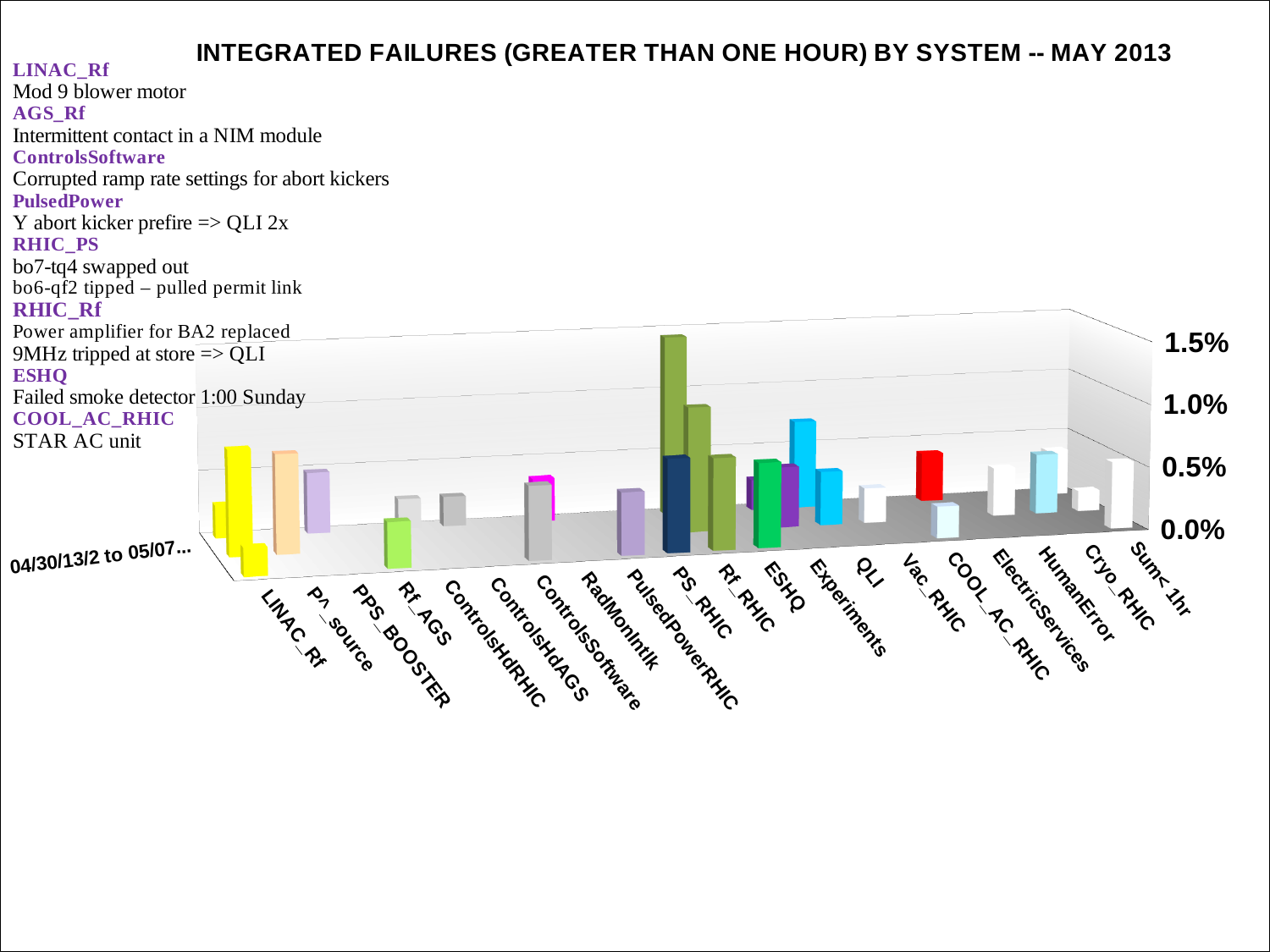
What is the title of the chart? INTEGRATED FAILURES (GREATER THAN ONE HOUR) BY SYSTEM -- MAY 2013 What is the first category label on the x axis? LINAC_Rf Which has the larger value, Rf_AGS or PS_RHIC? PS_RHIC Is the value for Rf_AGS greater or less than 0.5%? less What kind of chart is shown on the slide? bar chart How many system categories are listed along the x axis of the chart? 20 Is the tallest value for PS_RHIC greater or less than 1.0%? less Which system has the tallest bar in the chart? Rf_RHIC What is the highest tick value shown on the vertical axis? 1.5% What is the last category label on the x axis? Sum<1hr